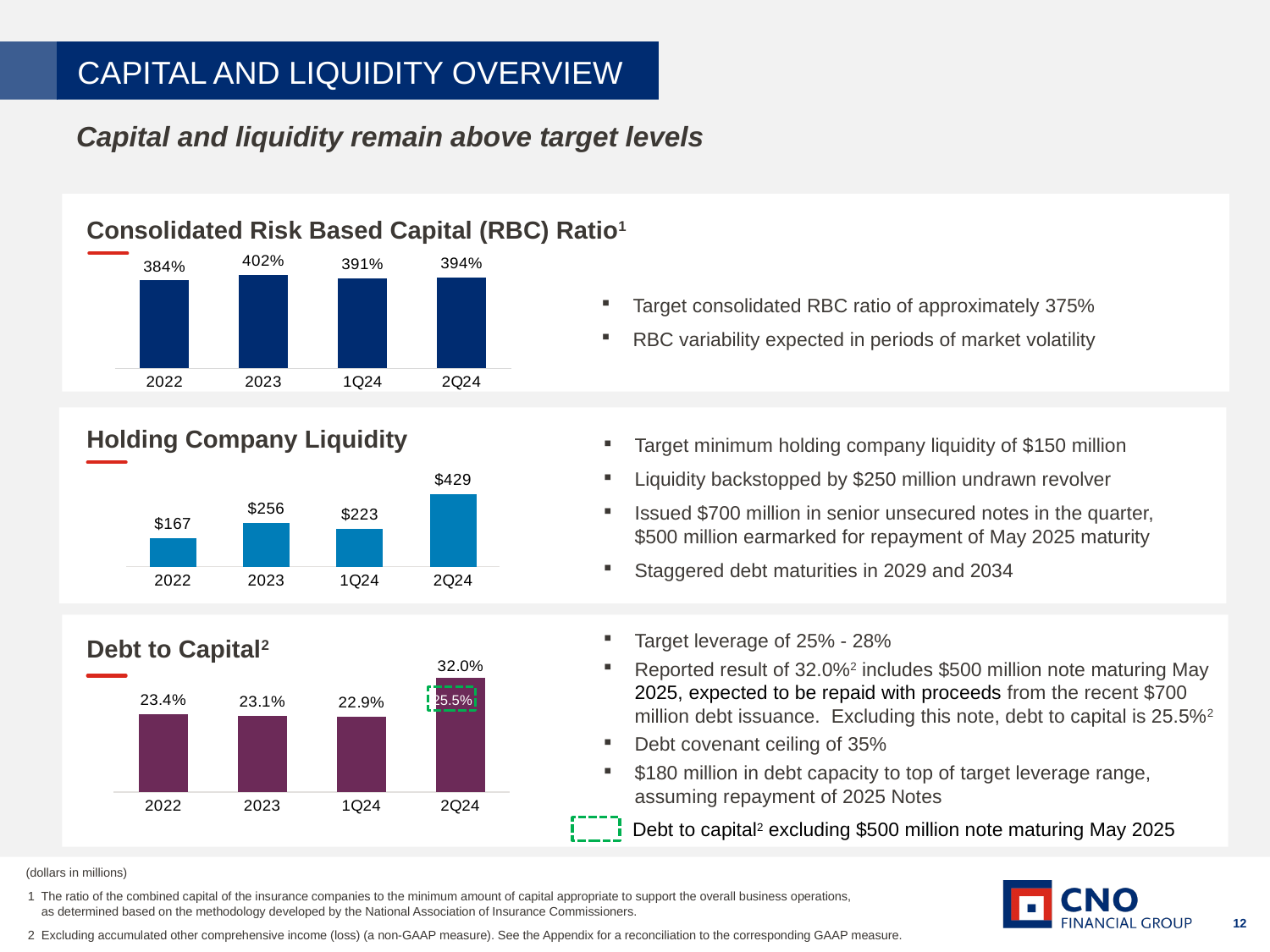
In the Debt to Capital chart, what is the reported value for 2Q24? 32.0% In the Consolidated Risk Based Capital (RBC) Ratio chart, which period has the lowest value? 2022 How many periods are shown in the Debt to Capital chart? 4 In the Holding Company Liquidity chart, which is larger, the value for 2023 or the value for 1Q24? 2023 In the Holding Company Liquidity chart, what is the difference between the 2Q24 and 1Q24 values? $206 In the Holding Company Liquidity chart, which period has the highest value? 2Q24 What type of chart is the Holding Company Liquidity chart? Bar chart In the Consolidated Risk Based Capital (RBC) Ratio chart, what is the difference between the 2023 and 2022 values? 18% In the Consolidated Risk Based Capital (RBC) Ratio chart, what is the value for 2023? 402% In the Debt to Capital chart, what is the value for 1Q24? 22.9% In the Debt to Capital chart, what is the 2Q24 value excluding the $500 million note maturing May 2025? 25.5% In the Holding Company Liquidity chart, what is the value for 2Q24? $429